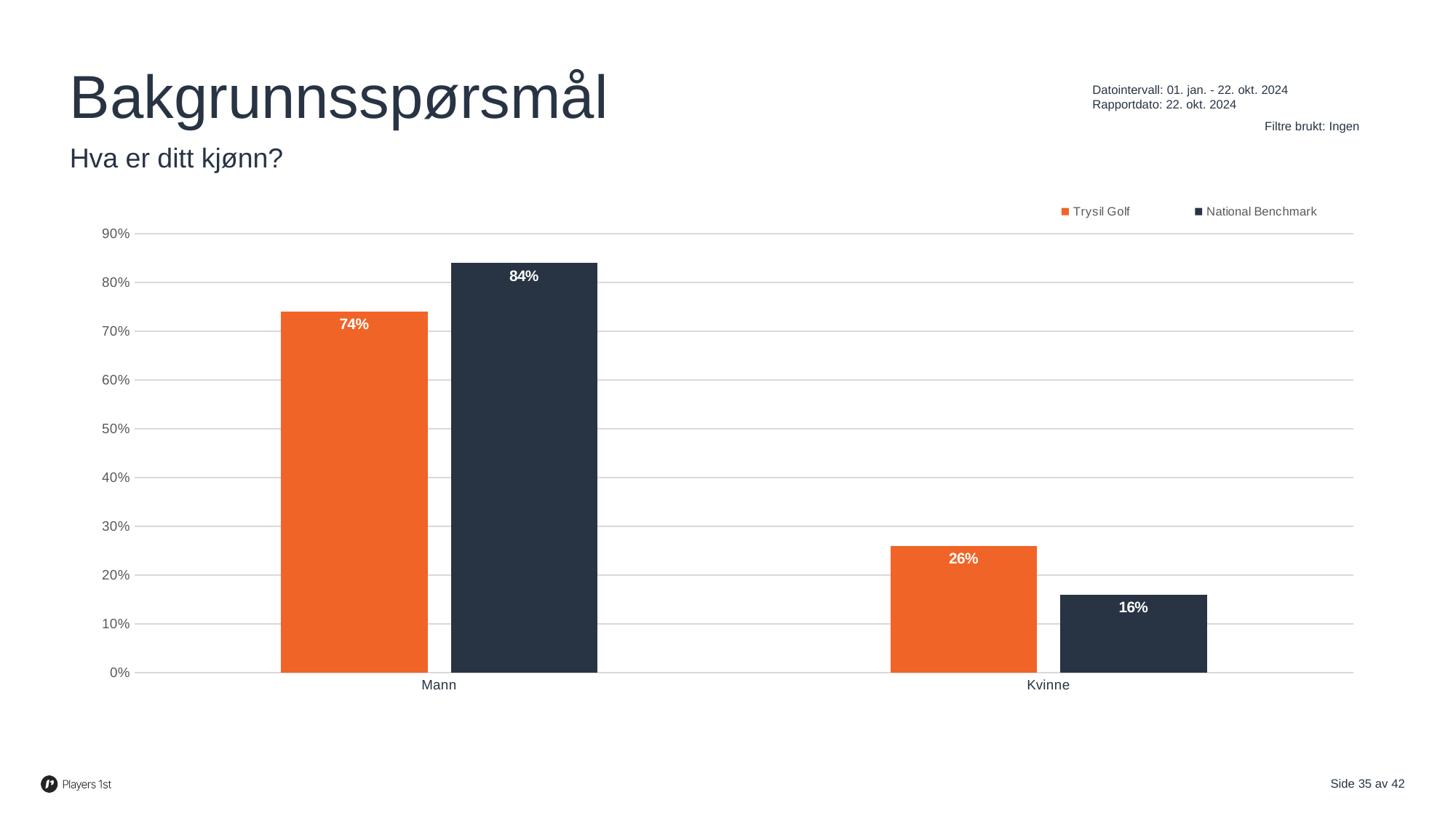
What is the National Benchmark value for Kvinne? 16% How many categories are shown on the x axis? 2 What is the Trysil Golf value for Kvinne? 26% What kind of chart is shown on the slide? Bar chart Which series is shown in orange? Trysil Golf Which is larger for Kvinne: Trysil Golf or National Benchmark? Trysil Golf What is the National Benchmark value for Mann? 84% How many series does the legend list? 2 Which category has the highest National Benchmark value? Mann What is the Trysil Golf value for Mann? 74% What is the difference between the National Benchmark and Trysil Golf values for Mann? 10% Which category has the lowest Trysil Golf value? Kvinne